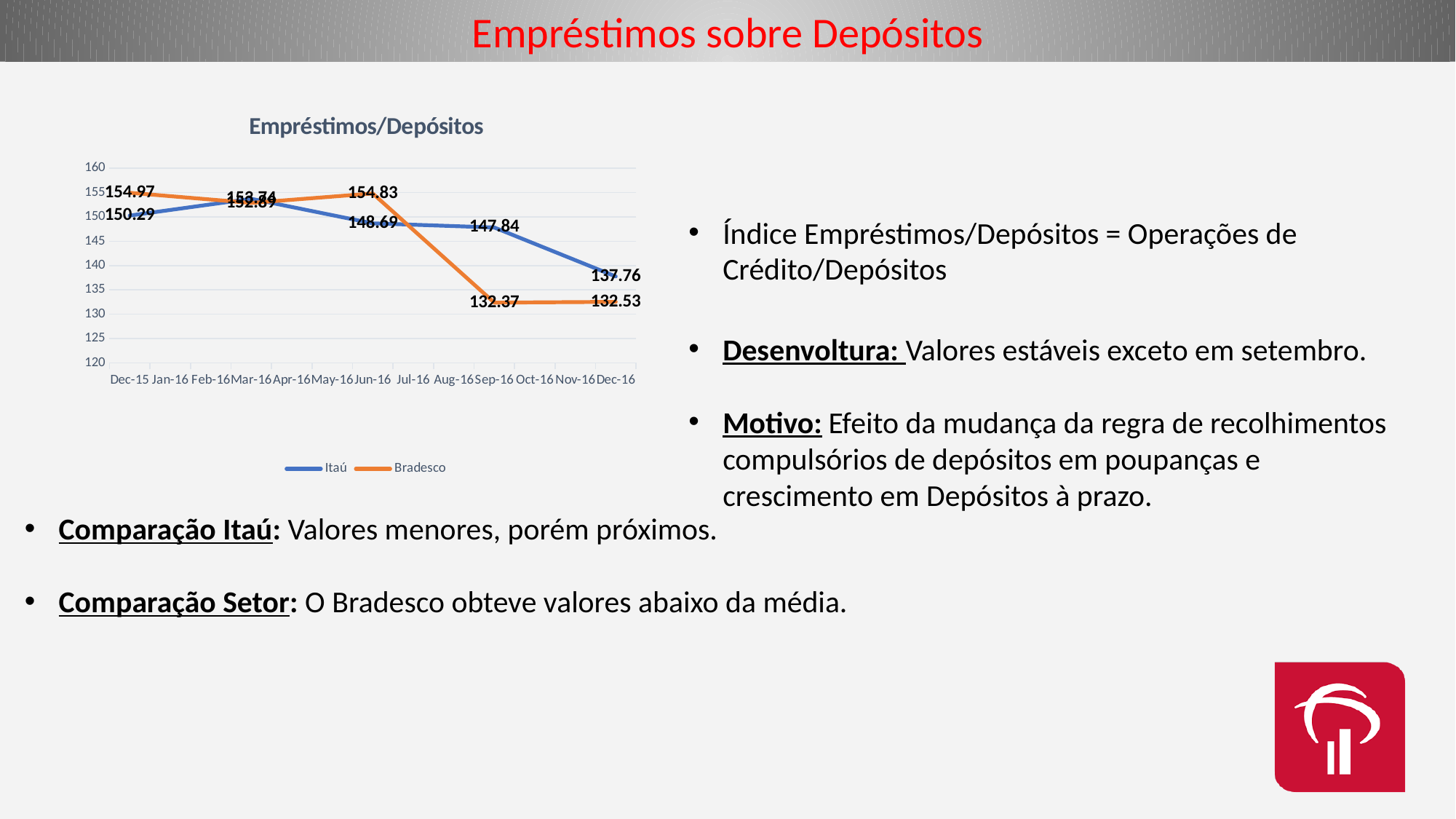
How many series does the legend of the Empréstimos/Depósitos chart list? 2 What is the Itaú value for Dec-15 in the Empréstimos/Depósitos chart? 150.29 In Jun-16, which series has the higher value, Itaú or Bradesco? Bradesco At which month does the Bradesco series reach its lowest labelled value? Sep-16 What is the difference between the Itaú and Bradesco values for Dec-16? 5.23 What is the Itaú value for Sep-16? 147.84 Which colour represents Bradesco in the legend? orange What is the Bradesco value for Jun-16? 154.83 What is the Itaú value for Dec-16? 137.76 What is the Bradesco value for Dec-15 in the Empréstimos/Depósitos chart? 154.97 What is the Bradesco value for Dec-16? 132.53 What kind of chart is shown on the slide? line chart